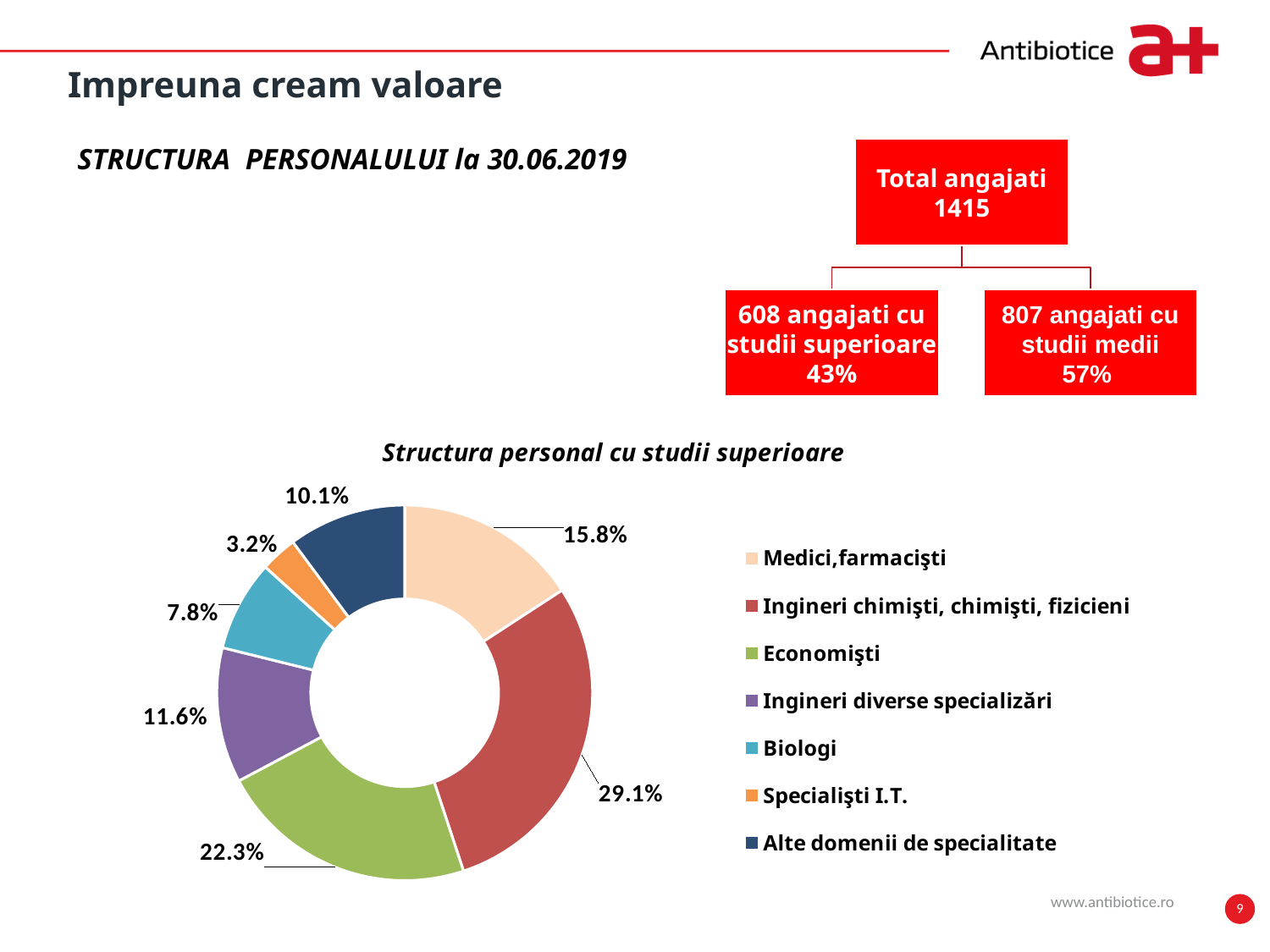
What percentage is shown for Biologi? 7.8% How many categories does the legend of the chart list? 7 What colour is the slice for Economiști? green What percentage is shown for Ingineri chimiști, chimiști, fizicieni? 29.1% What percentage of the chart is labelled for Medici,farmaciști? 15.8% Which category has the largest share of the chart? Ingineri chimiști, chimiști, fizicieni Which is larger, the share for Alte domenii de specialitate or the share for Biologi? Alte domenii de specialitate What kind of chart is shown under the title 'Structura personal cu studii superioare'? doughnut chart Which category has the smallest share of the chart? Specialiști I.T. What percentage is shown for Specialiști I.T.? 3.2% What percentage is shown for Economiști? 22.3% What is the difference in percentage points between Economiști and Ingineri diverse specializări? 10.7